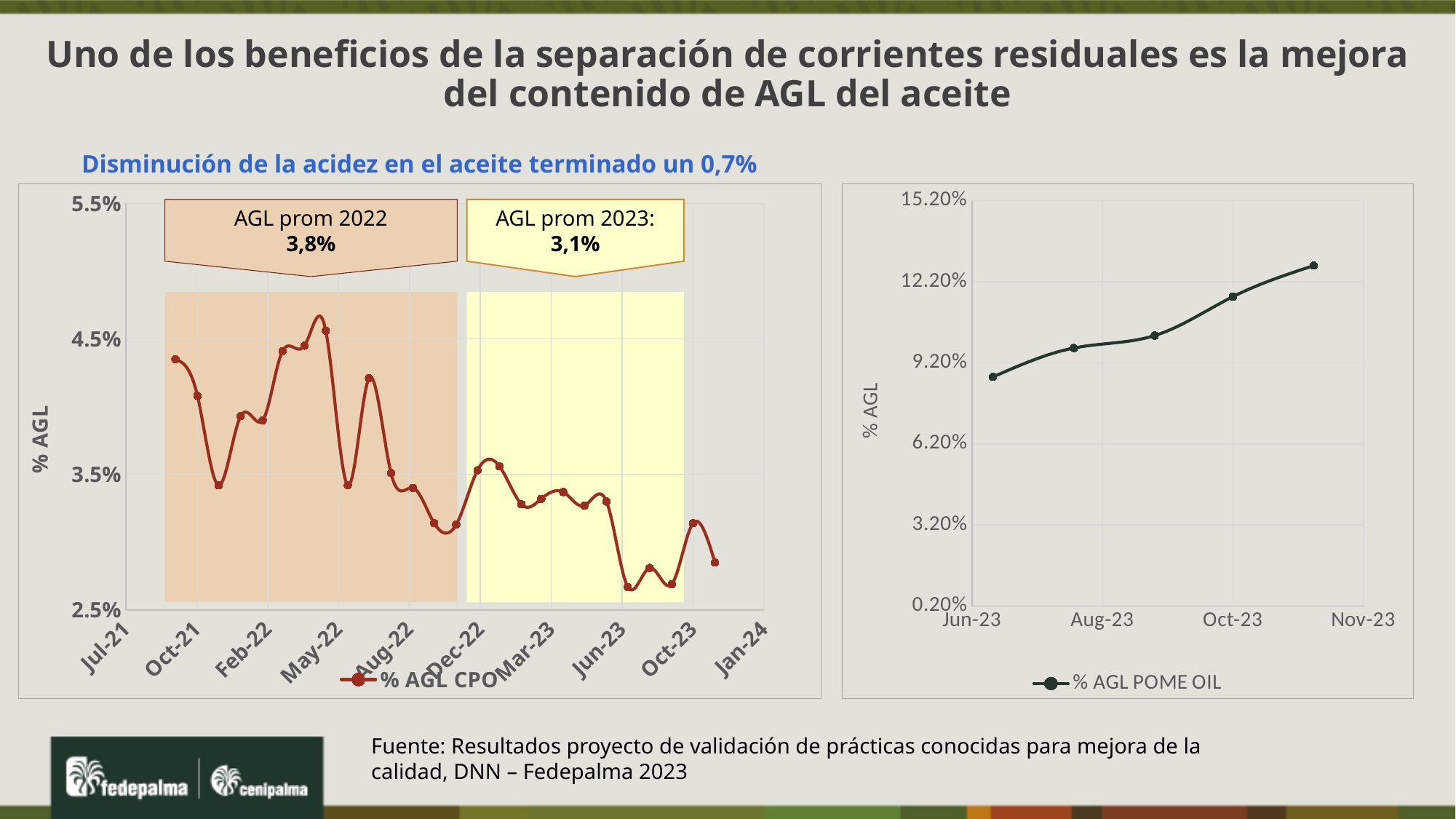
How many data points are plotted on the right chart (% AGL POME OIL)? 5 What kind of chart is the left chart (% AGL CPO)? line chart On the left chart, what is the AGL prom 2023 value shown in the annotation? 3,1% What kind of chart is the right chart (% AGL POME OIL)? line chart On the left chart, which annotated average is larger, AGL prom 2022 or AGL prom 2023? AGL prom 2022 On the right chart, is the % AGL POME OIL value at Jun-23 greater or less than 6.20%? greater On the left chart, what is the difference between the AGL prom 2022 and AGL prom 2023 values? 0,7% On the left chart, is the % AGL CPO value at Oct-21 greater or less than 3.5%? greater On the left chart, is the % AGL CPO value at Jun-23 greater or less than 3.5%? less On the right chart, do the % AGL POME OIL values rise or fall from Jun-23 onward? rise On the left chart, what is the AGL prom 2022 value shown in the annotation? 3,8% How many series does the legend of the right chart list? 1